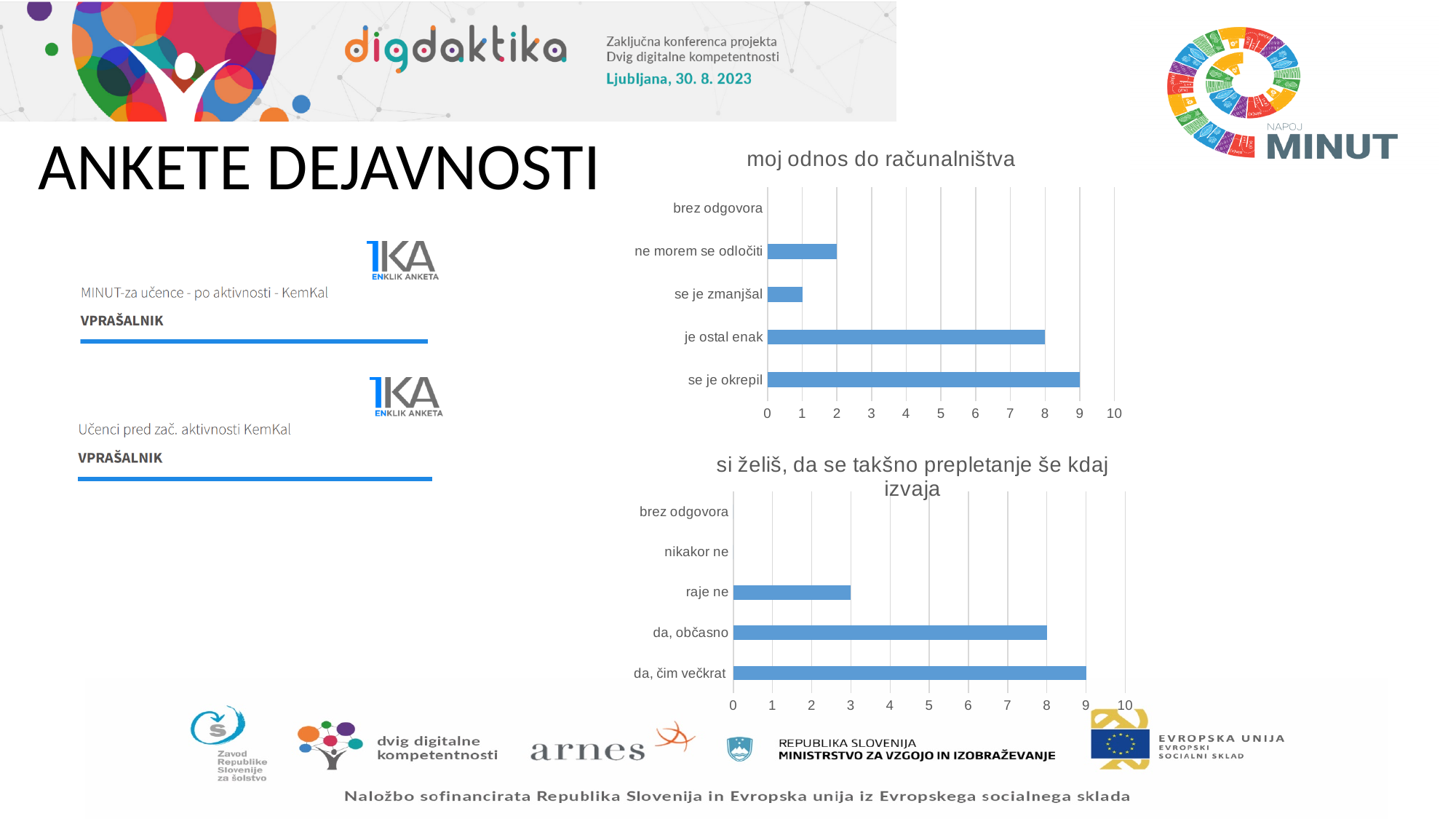
In the chart titled "moj odnos do računalništva", is the value for "je ostal enak" greater or less than 5? greater In the chart titled "si želiš, da se takšno prepletanje še kdaj izvaja", what is the value for "raje ne"? 3 In the chart titled "moj odnos do računalništva", what is the value for "je ostal enak"? 8 In the chart titled "moj odnos do računalništva", which category has the highest value? se je okrepil In the chart titled "si želiš, da se takšno prepletanje še kdaj izvaja", what is the difference between "da, čim večkrat" and "da, občasno"? 1 What kind of chart is the chart titled "si želiš, da se takšno prepletanje še kdaj izvaja"? bar chart What is the maximum value shown on the horizontal axis of the chart titled "moj odnos do računalništva"? 10 In the chart titled "si želiš, da se takšno prepletanje še kdaj izvaja", what is the value for "da, čim večkrat"? 9 In the chart titled "moj odnos do računalništva", what is the value for "se je okrepil"? 9 In the chart titled "moj odnos do računalništva", what is the difference between "ne morem se odločiti" and "se je zmanjšal"? 1 In the chart titled "moj odnos do računalništva", how many categories are shown on the vertical axis? 5 In the chart titled "si želiš, da se takšno prepletanje še kdaj izvaja", which is larger: "da, občasno" or "raje ne"? da, občasno